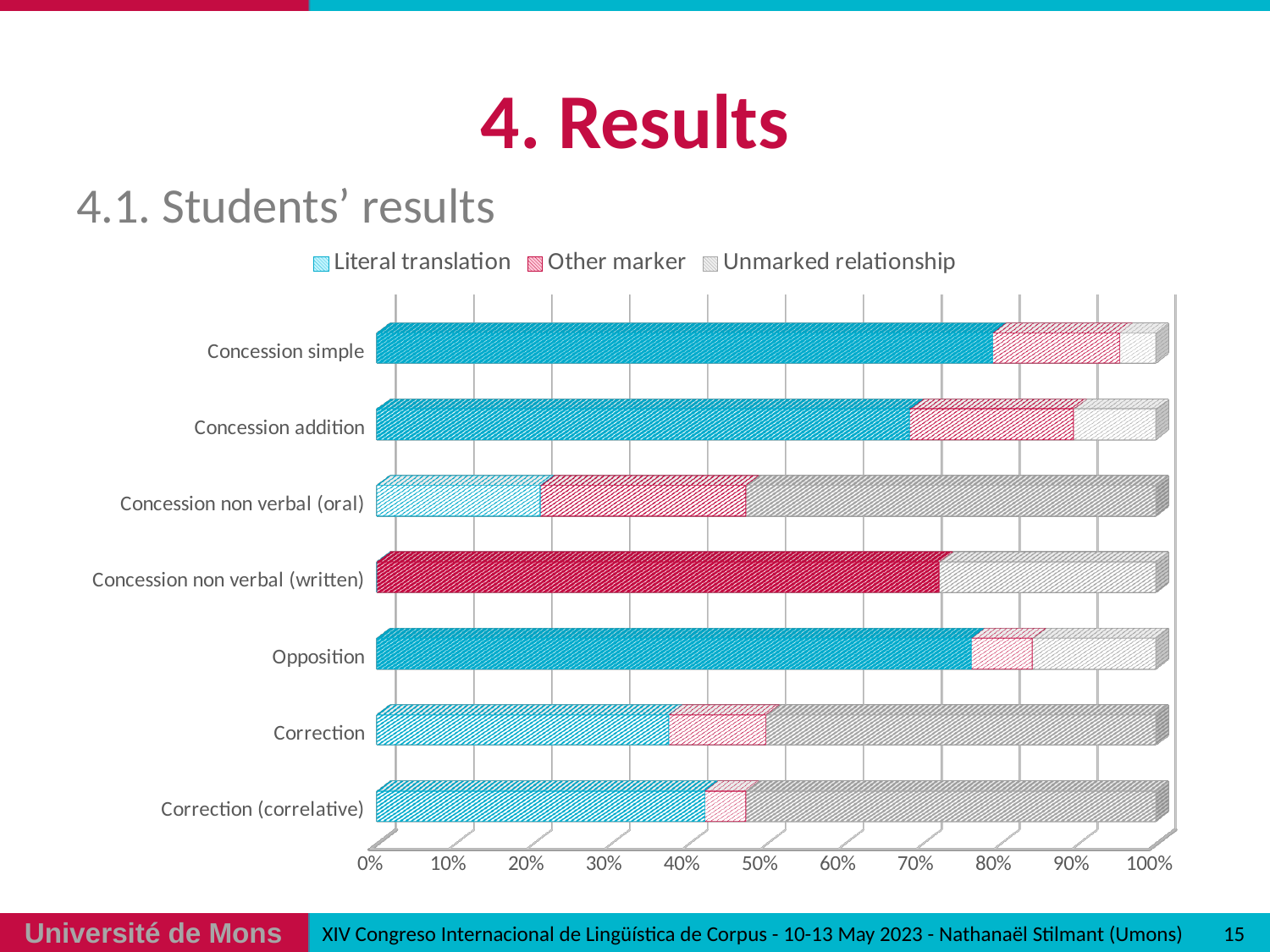
Is the Literal translation share for Opposition greater or less than 70%? greater How many series does the chart legend list? 3 What kind of chart is shown on the slide? bar chart Is the Other marker share for Concession non verbal (written) greater or less than 60%? greater How many categories are plotted on the chart? 7 Is the Literal translation share for Concession non verbal (oral) greater or less than 30%? less Which has a larger Literal translation share, Concession simple or Correction? Concession simple Which series are listed in the chart legend? Literal translation, Other marker, Unmarked relationship Which has a larger Other marker share, Concession non verbal (written) or Opposition? Concession non verbal (written) Which category has the lowest share of Literal translation? Concession non verbal (written) Which category has the highest share of Other marker? Concession non verbal (written)